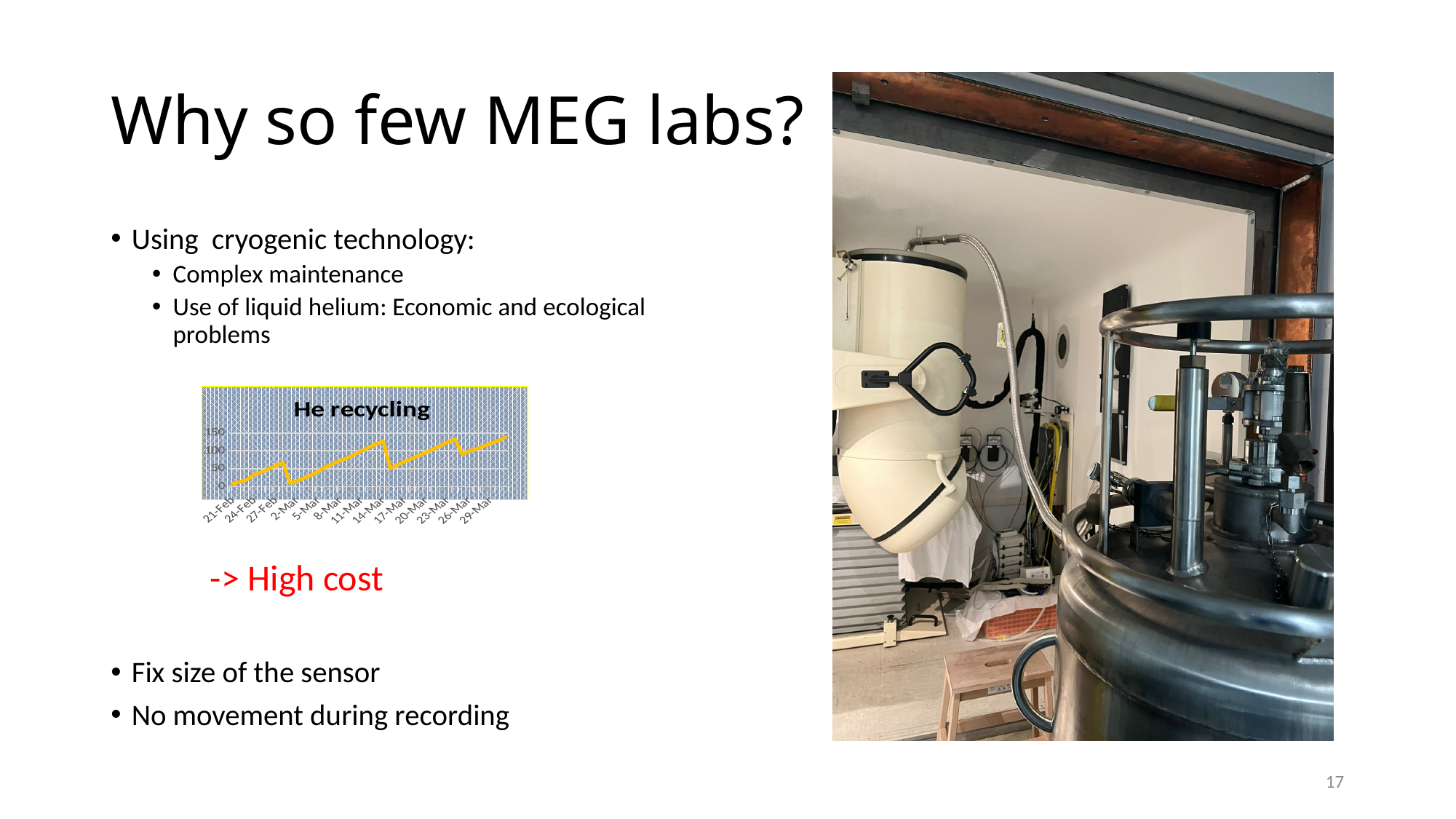
What is the first date label on the x axis of the "He recycling" chart? 21-Feb What is the title of the chart on the slide? He recycling In the "He recycling" chart, is the value at 29-Mar greater or less than 50? greater What is the highest tick value shown on the y axis of the "He recycling" chart? 150 How many date labels are shown on the x axis of the "He recycling" chart? 13 In the "He recycling" chart, which is larger, the value at 21-Feb or the value at 29-Mar? 29-Mar In the "He recycling" chart, is the value at 21-Feb greater or less than 50? less What kind of chart is the "He recycling" chart? line chart In the "He recycling" chart, is the value at 2-Mar greater or less than 50? less